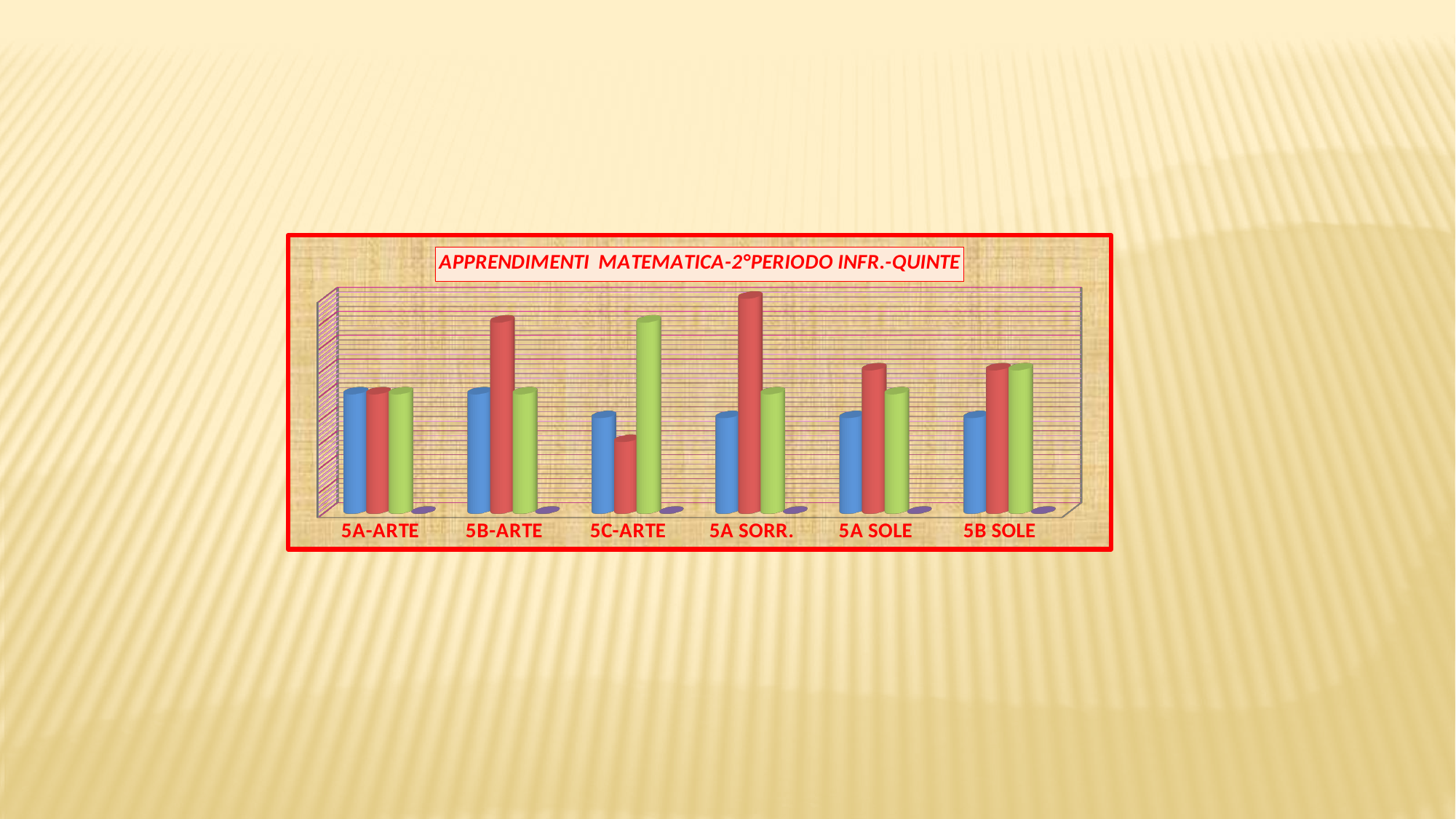
In the 5A SORR. category, which bar is taller, the red one or the green one? red Which category has the tallest red bar? 5A SORR. In the 5C-ARTE category, which bar is taller, the red one or the green one? green What kind of chart is shown on the slide? bar chart How many bars are plotted for each category in the chart? 3 In the 5B-ARTE category, which bar is taller, the blue one or the red one? red What is the title of the chart? APPRENDIMENTI MATEMATICA-2°PERIODO INFR.-QUINTE How many categories are shown on the x axis of the chart? 6 Which category has the tallest green bar? 5C-ARTE Which category has the shortest red bar? 5C-ARTE What is the label of the first category on the x axis? 5A-ARTE